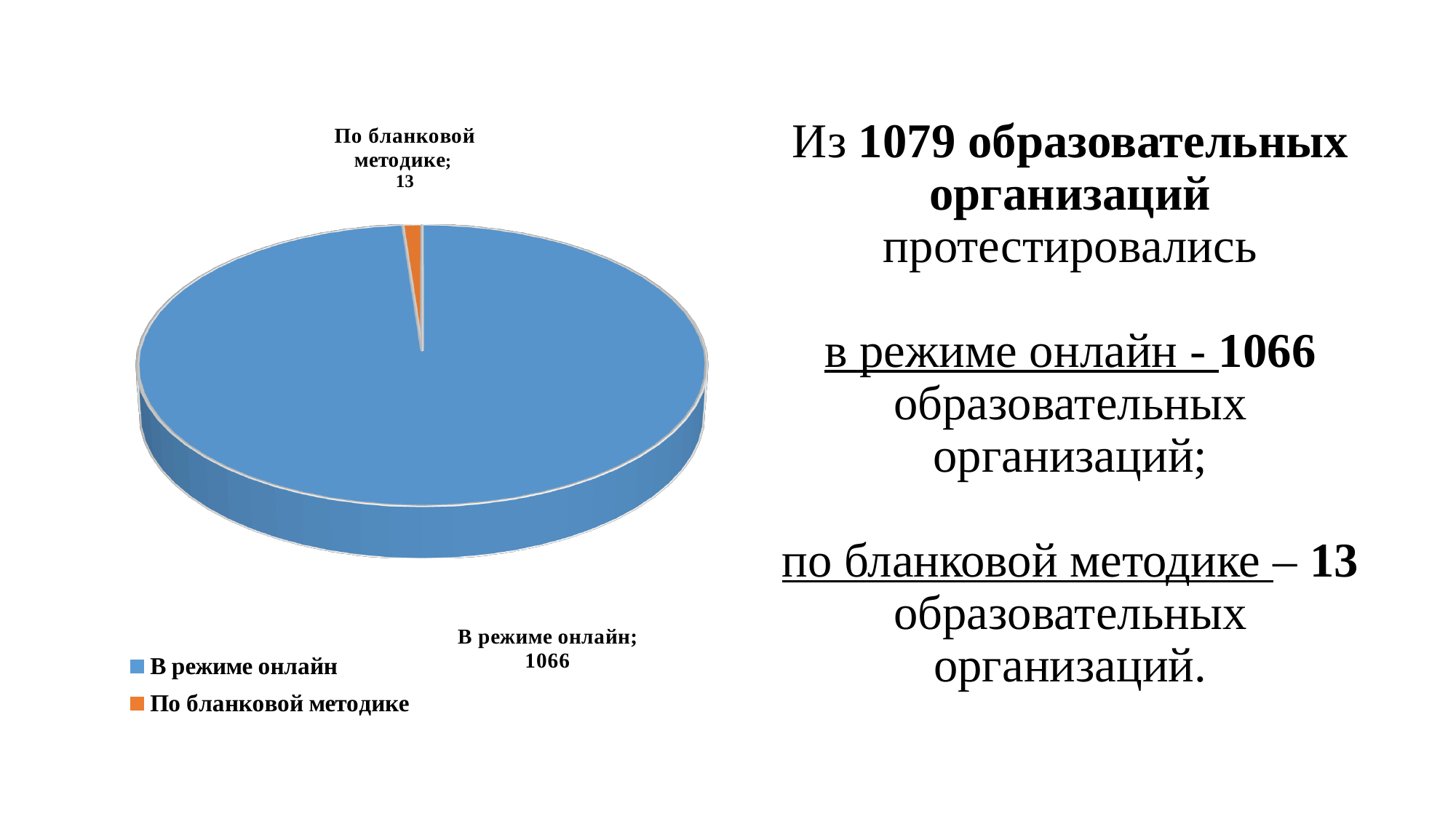
What is the difference between the values for "В режиме онлайн" and "По бланковой методике"? 1053 What colour is the slice for "В режиме онлайн"? blue How many categories does the pie chart show? 2 Which category has the smallest slice in the pie chart? По бланковой методике What colour is the slice for "По бланковой методике"? orange What is the value for "По бланковой методике" in the pie chart? 13 What is the total of the two values shown in the pie chart? 1079 Which category has the largest slice in the pie chart? В режиме онлайн What is the value for "В режиме онлайн" in the pie chart? 1066 Which is larger: the value for "В режиме онлайн" or for "По бланковой методике"? В режиме онлайн What kind of chart is shown on the slide? pie chart